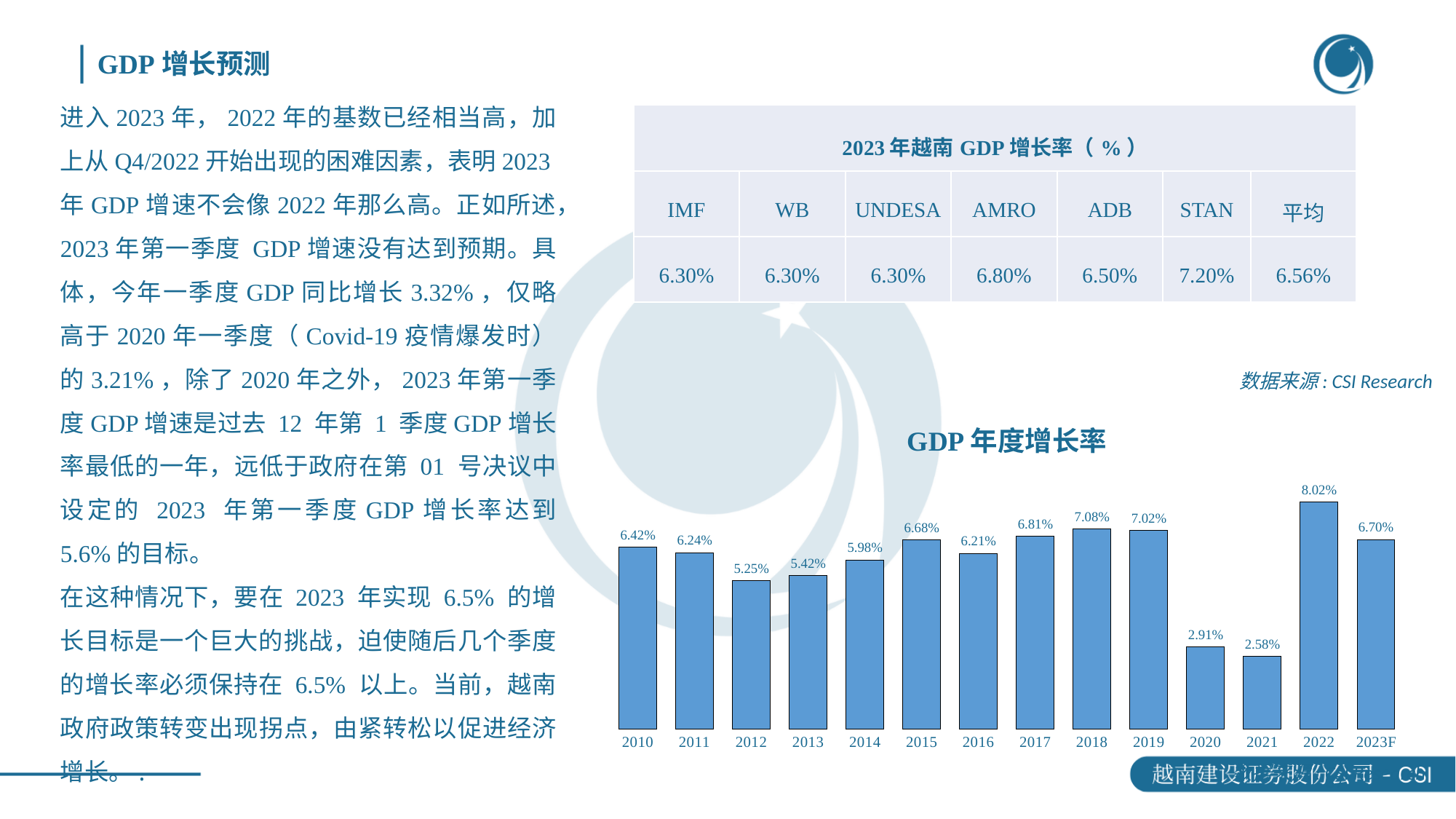
In the "GDP 年度增长率" chart, what is the value for 2020? 2.91% What type of chart is shown under the title "GDP 年度增长率"? bar chart In the "GDP 年度增长率" chart, do the values rise or fall from 2019 to 2021? fall In the "GDP 年度增长率" chart, which year has the highest value? 2022 In the "GDP 年度增长率" chart, what is the difference between the values for 2022 and 2021? 5.44% In the "GDP 年度增长率" chart, what is the difference between the values for 2012 and 2013? 0.17% In the "GDP 年度增长率" chart, what is the value for 2023F? 6.70% In the "GDP 年度增长率" chart, what is the value for 2022? 8.02% In the "GDP 年度增长率" chart, how many years are plotted? 14 What is the title of the bar chart on the slide? GDP 年度增长率 In the "GDP 年度增长率" chart, which is larger, the value for 2018 or the value for 2019? 2018 In the "GDP 年度增长率" chart, which year has the lowest value? 2021